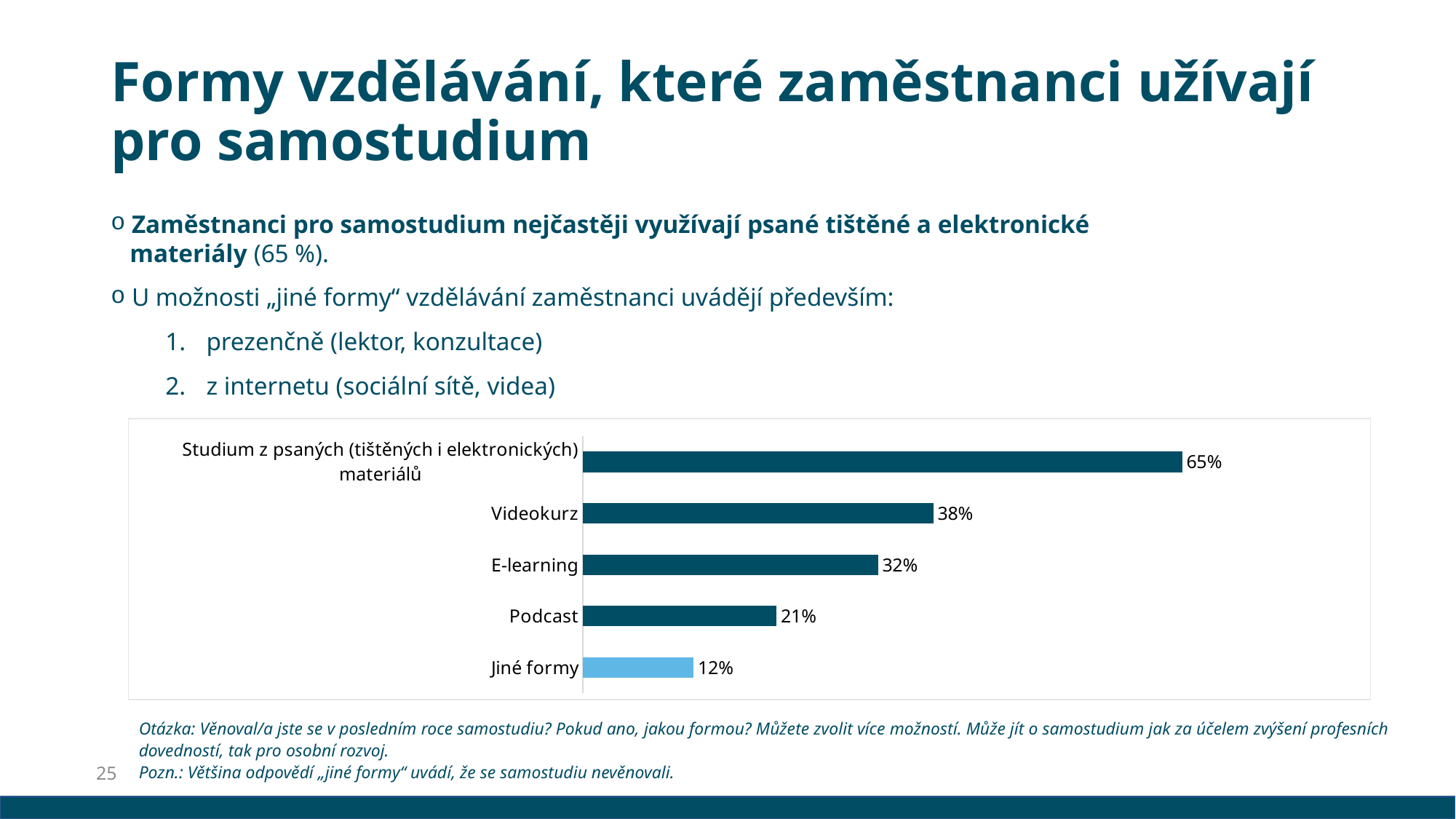
Which bar is shown in a different (light blue) colour from the others? Jiné formy Which category has the lowest value? Jiné formy What is the value for Jiné formy? 12% What is the value for Videokurz? 38% What is the difference between the values for Videokurz and E-learning? 6% What is the difference between the values for Studium z psaných (tištěných i elektronických) materiálů and Podcast? 44% Which category has the highest value? Studium z psaných (tištěných i elektronických) materiálů Which is larger, the value for Podcast or the value for E-learning? E-learning What is the value for Podcast? 21% What kind of chart is shown on the slide? Bar chart What is the value for E-learning? 32% How many categories are shown in the chart? 5